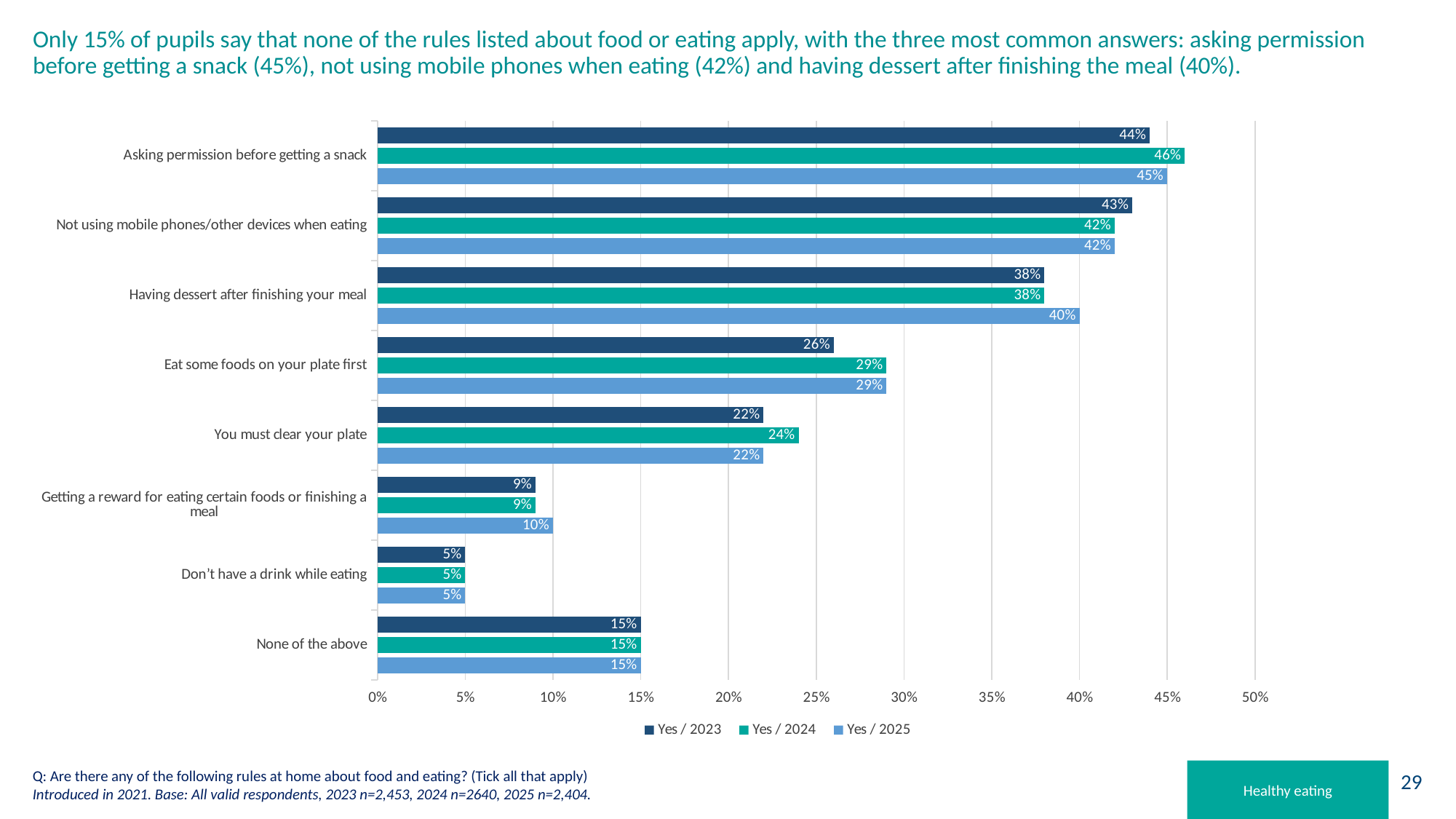
Which category has the highest value in the Yes / 2024 series? Asking permission before getting a snack Which category has the lowest value in the Yes / 2025 series? Don't have a drink while eating What is the value for 'Eat some foods on your plate first' in the Yes / 2023 series? 26% Which is larger for 'Not using mobile phones/other devices when eating': the Yes / 2023 value or the Yes / 2025 value? Yes / 2023 What is the value for 'Asking permission before getting a snack' in the Yes / 2025 series? 45% What is the value for 'You must clear your plate' in the Yes / 2024 series? 24% What is the label of the third series in the legend? Yes / 2025 What is the difference between the Yes / 2025 and Yes / 2023 values for 'Having dessert after finishing your meal'? 2% How many series does the legend list? 3 What is the value for 'None of the above' in the Yes / 2023 series? 15% How many categories are shown on the chart? 8 What kind of chart is shown on the slide? Bar chart